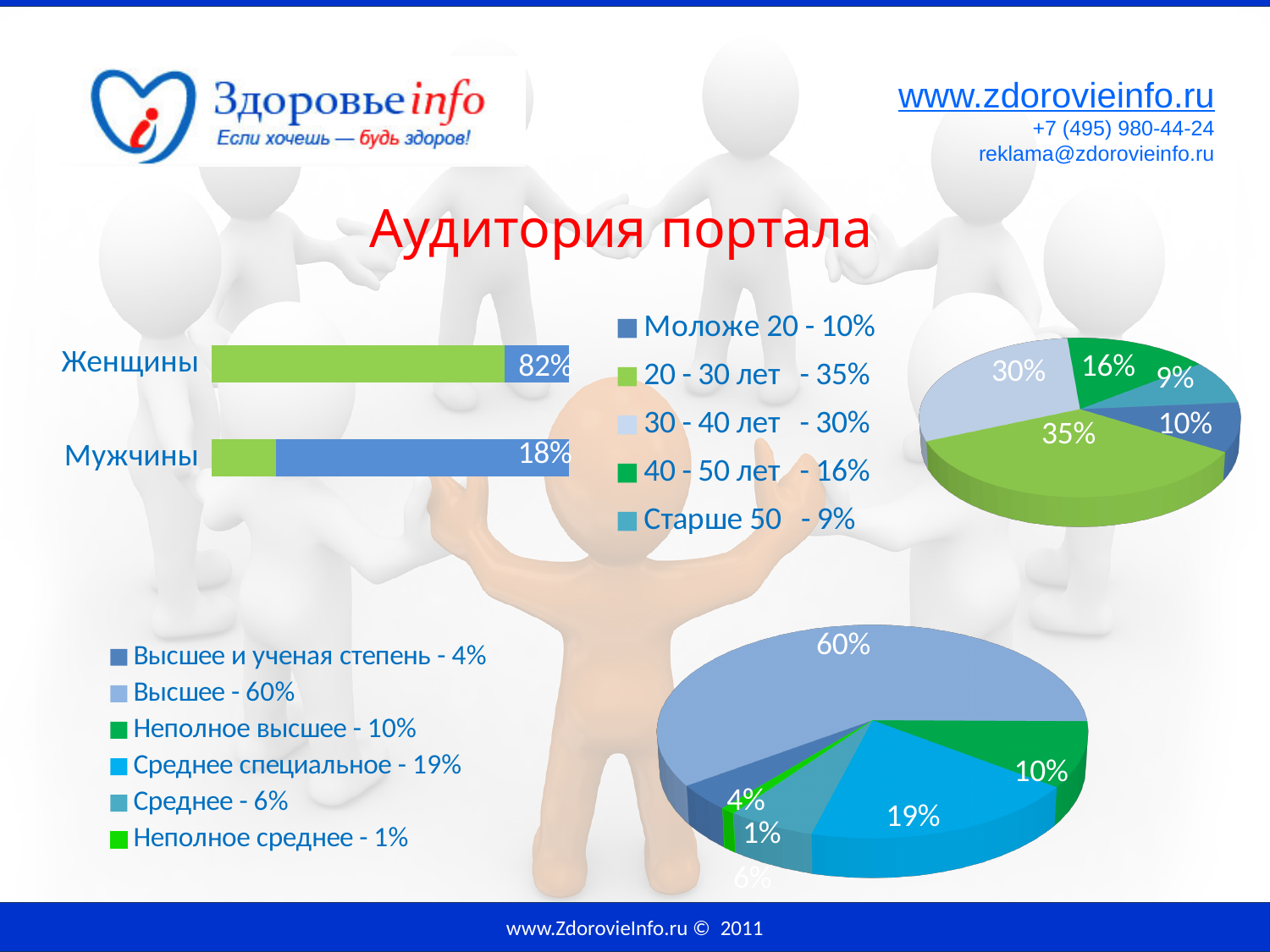
In the bar chart on the left, what is the value for Женщины? 82% In the bar chart on the left, what is the difference between the values for Женщины and Мужчины? 64% How many categories does the legend of the education pie chart at the bottom right list? 6 In the age pie chart at the top right, what is the share for 20 - 30 лет? 35% How many categories does the legend of the age pie chart at the top right list? 5 In the education pie chart at the bottom right, which is larger: Неполное высшее or Среднее? Неполное высшее In the education pie chart at the bottom right, which category has the largest share? Высшее In the bar chart on the left, what is the value for Мужчины? 18% In the age pie chart at the top right, which age group has the smallest share? Старше 50 In the education pie chart at the bottom right, what is the share for Среднее специальное? 19% What kind of chart is the chart on the left showing Женщины and Мужчины? bar chart In the age pie chart at the top right, which age group has the largest share? 20 - 30 лет